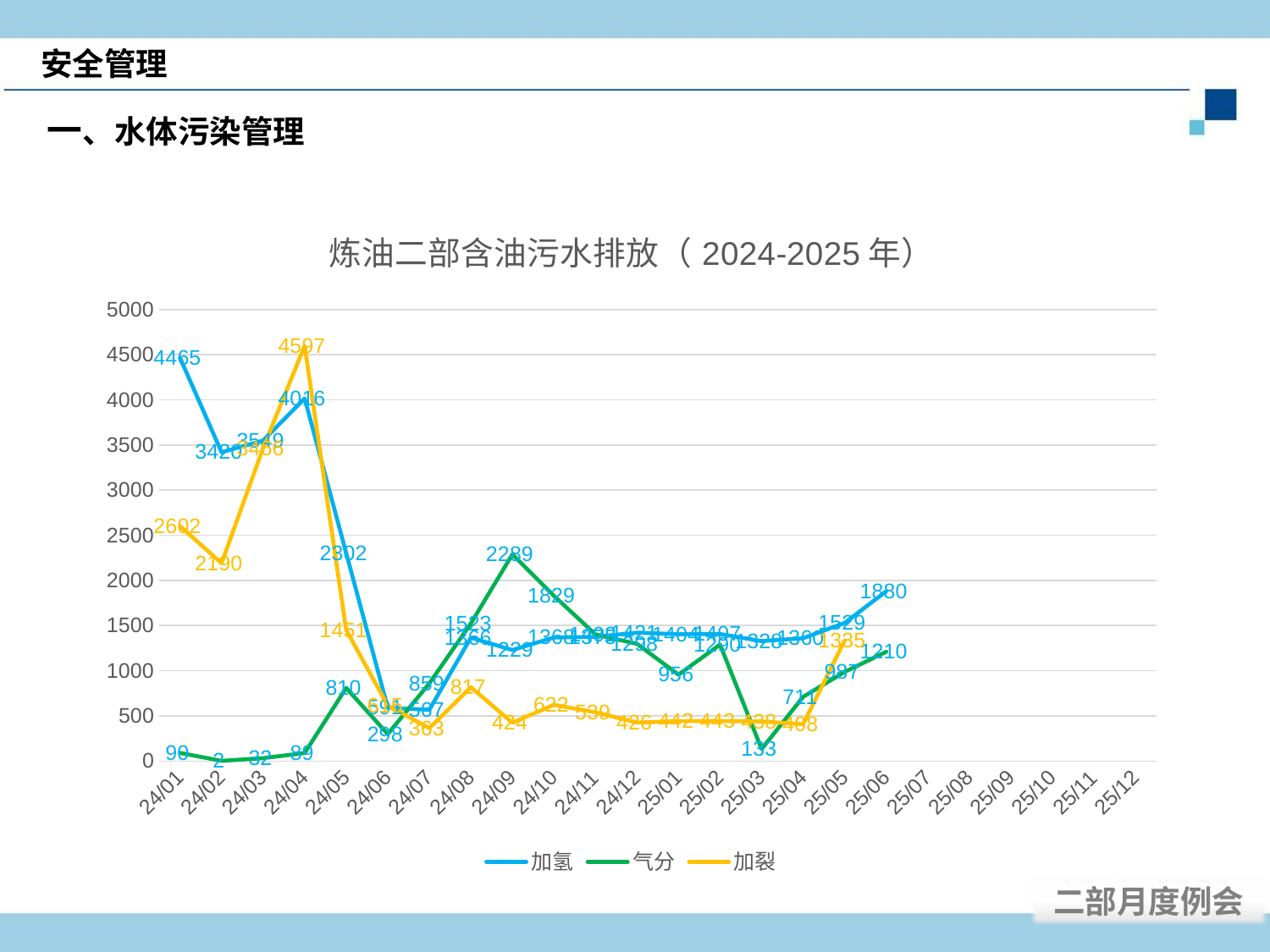
What is the value for 加裂 in 24/04? 4597 What are the three series named in the legend? 加氢, 气分, 加裂 In which month does 加裂 reach its highest value? 24/04 What is the value for 气分 in 25/03? 133 What is the value for 气分 in 24/09? 2289 Is the value for 加氢 in 24/02 greater or less than 3000? greater What is the difference between the 加氢 values in 24/01 and 24/04? 449 What kind of chart is shown on the slide? line chart What is the value for 加氢 in 25/06? 1880 In 24/05, which is larger, 加氢 or 加裂? 加氢 What is the value for 加氢 in 24/01? 4465 How many series does the legend list? 3